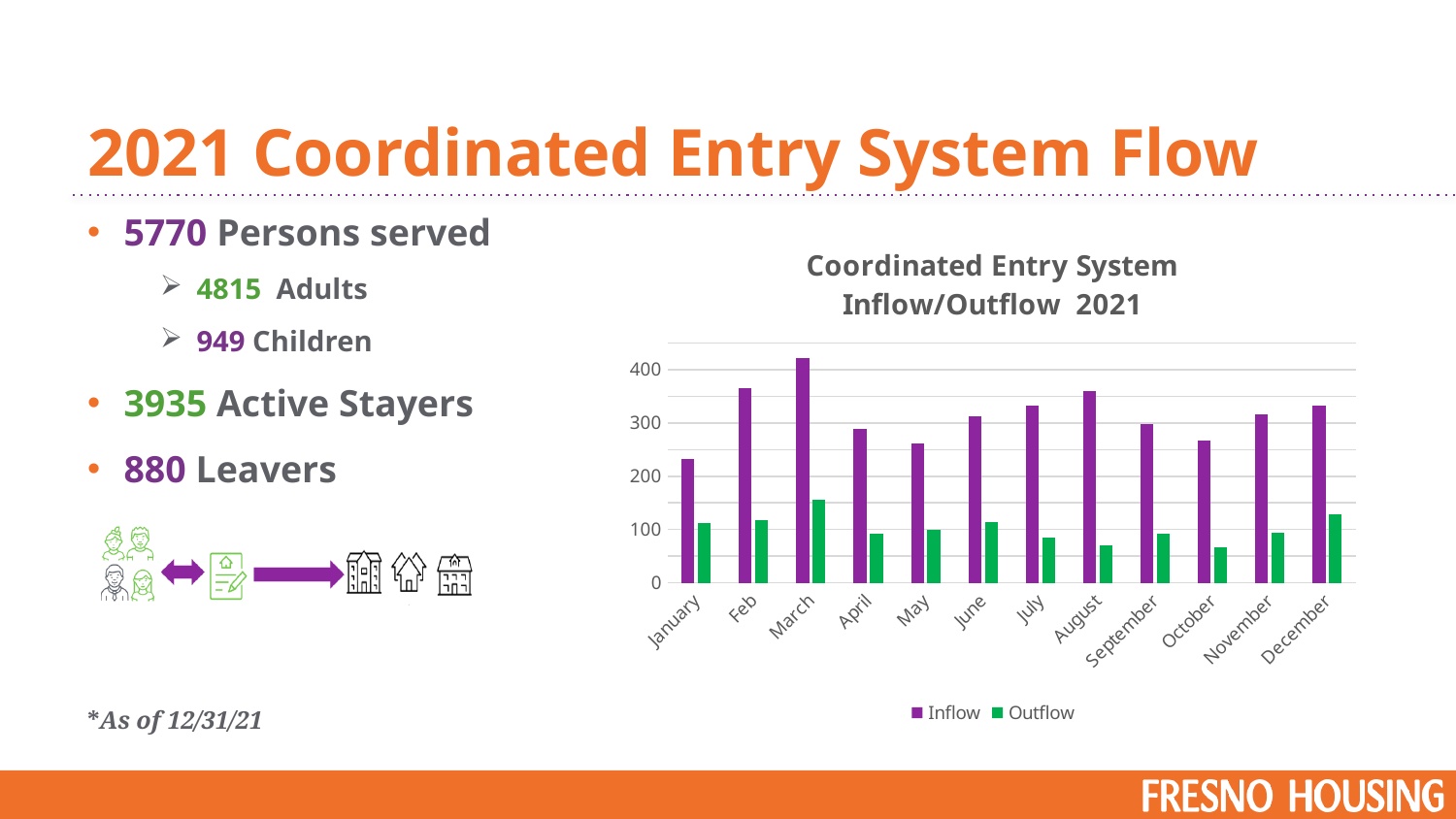
Which colour represents the Outflow series in the chart? green Is the Inflow value for March greater or less than 400? greater Which month has the highest Inflow value? March How many series does the chart legend list? 2 How many months are shown on the x axis of the chart? 12 Is the Outflow value for December greater or less than 100? greater Which is larger, the Inflow value for February or the Inflow value for January? February What is the title of the chart? Coordinated Entry System Inflow/Outflow 2021 Which month has the highest Outflow value? March What type of chart is shown on the slide? bar chart Is the Outflow value for August greater or less than 100? less Which month has the lowest Inflow value? January